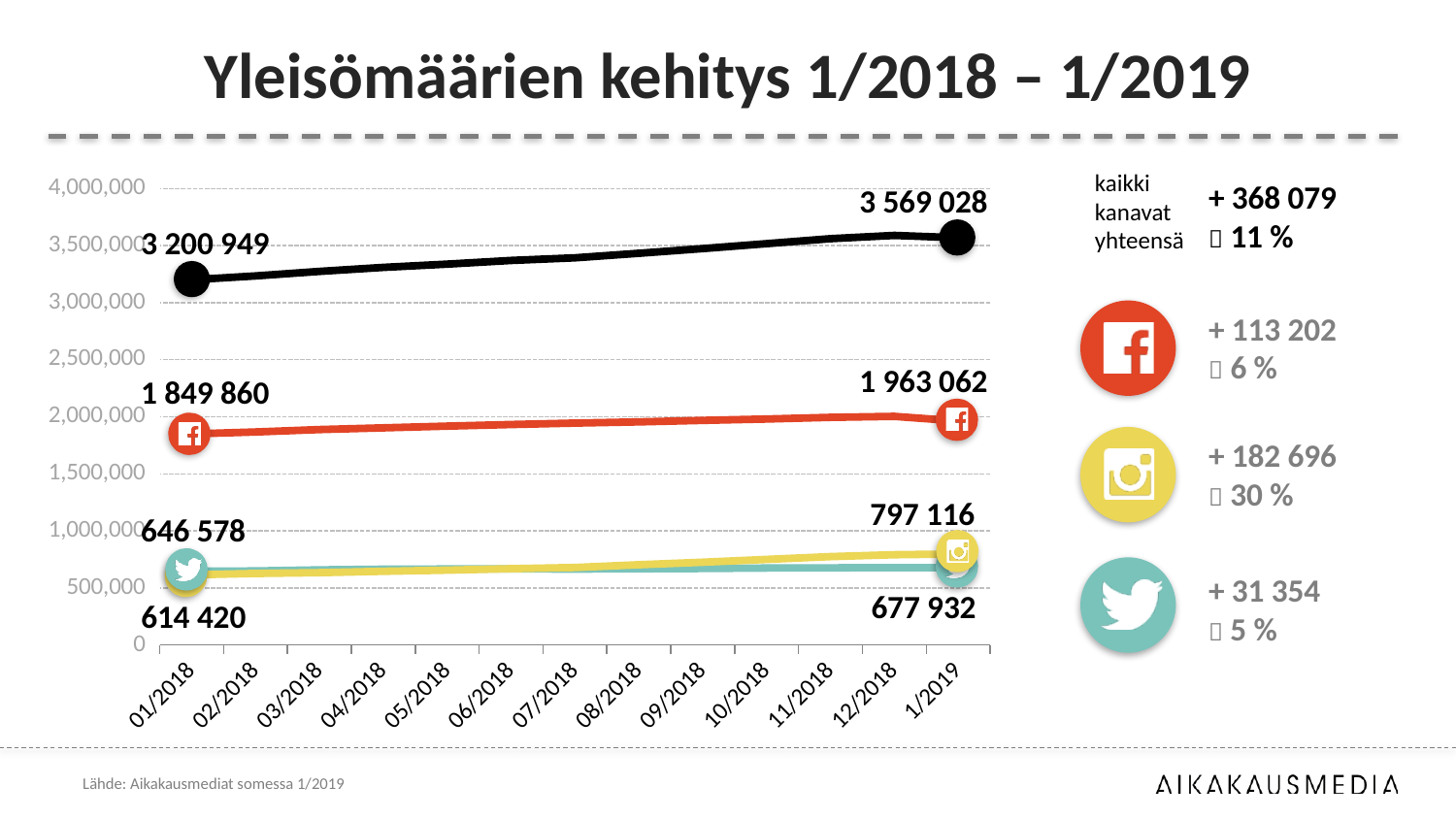
By how much did the Facebook (red) line increase from 01/2018 to 1/2019? 113 202 What is the value of the Instagram (yellow) line at 1/2019? 797 116 How many time points are shown on the x axis? 13 What is the value of the black (total) line at 01/2018? 3 200 949 What is the value of the Facebook (red) line at 1/2019? 1 963 062 What is the value of the Facebook (red) line at 01/2018? 1 849 860 Which line has the highest values throughout the chart? the black (total) line What is the value of the black (total) line at 1/2019? 3 569 028 By how much did the black (total) line increase from 01/2018 to 1/2019? 368 079 What type of chart is shown on the slide? line chart Does the black (total) line rise or fall from 01/2018 to 1/2019? rise Is the Facebook (red) line at 1/2019 greater or less than 2,000,000? less